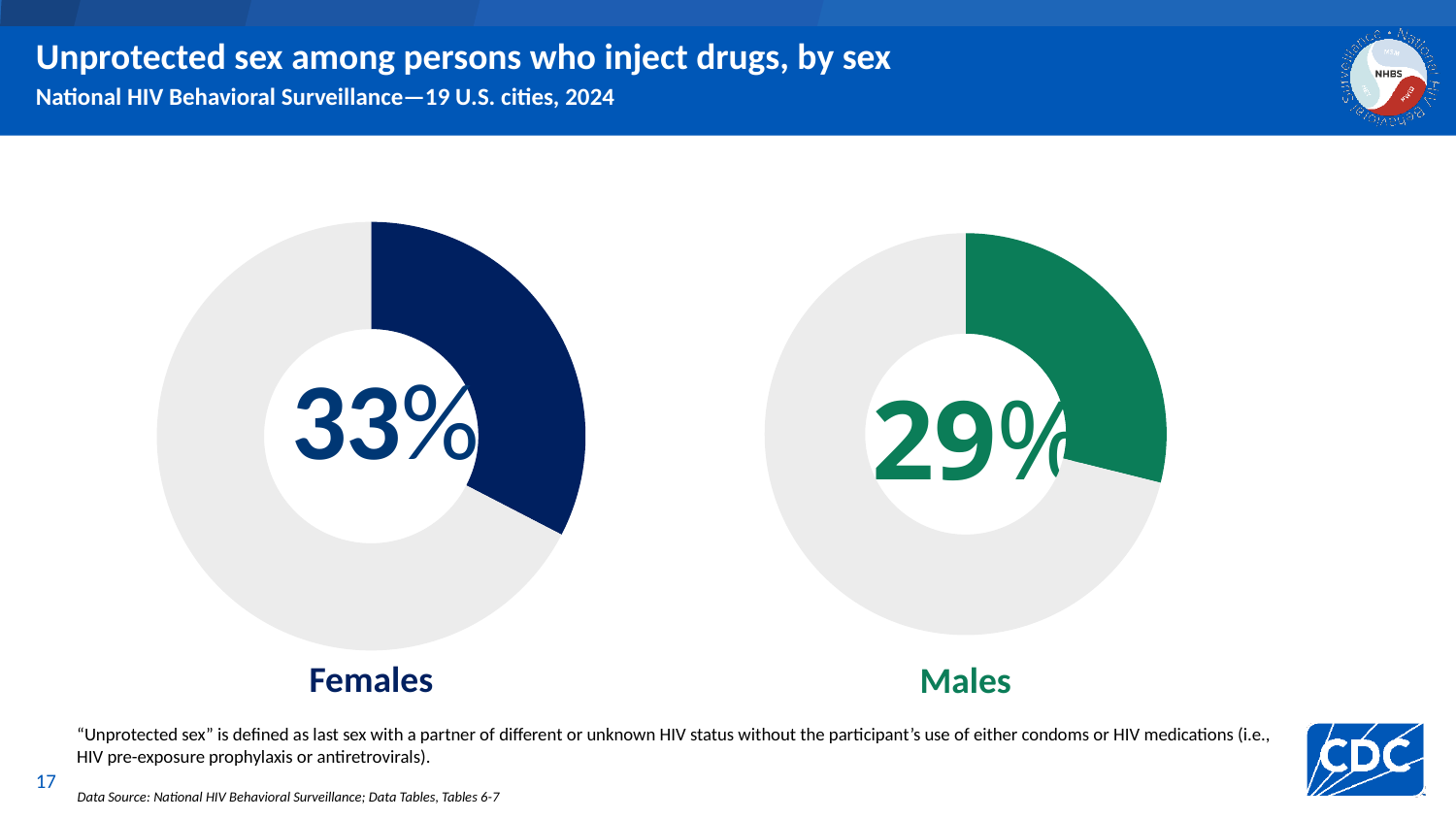
How many donut charts are shown on the slide? 2 What percentage of males who inject drugs reported unprotected sex? 29% Which group has the higher percentage of unprotected sex, females or males? Females Which group has the lower percentage of unprotected sex? Males Which group is shown in the left-hand donut chart? Females What percentage of females who inject drugs reported unprotected sex? 33% What is the difference in percentage points between females and males reporting unprotected sex? 4 percentage points What is the title of the slide? Unprotected sex among persons who inject drugs, by sex What colour is the filled portion of the Males donut chart? Green How many U.S. cities does the surveillance data cover? 19 Is the percentage for females greater or less than 50%? less What kind of chart is used to show the percentages on this slide? Donut (pie) chart